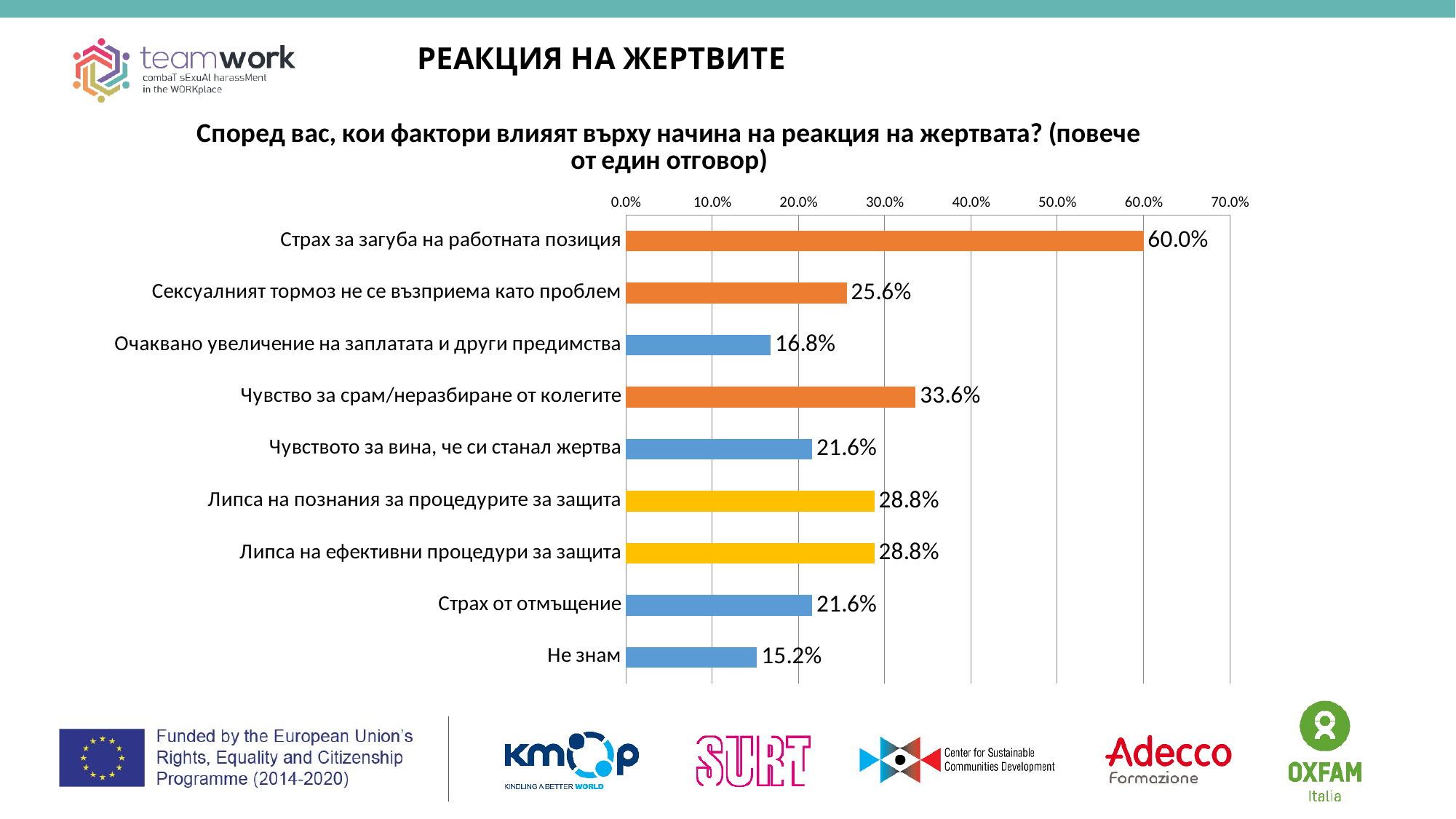
What is the difference between "Страх за загуба на работната позиция" and "Сексуалният тормоз не се възприема като проблем"? 34.4% What is the value for "Страх за загуба на работната позиция"? 60.0% What is the value for "Липса на ефективни процедури за защита"? 28.8% What kind of chart is shown on the slide? bar chart How many categories are shown in the chart? 9 Which is larger: "Очаквано увеличение на заплатата и други предимства" or "Чувството за вина, че си станал жертва"? Чувството за вина, че си станал жертва What is the maximum value shown on the horizontal axis? 70.0% Is the value for "Чувство за срам/неразбиране от колегите" greater or less than 30.0%? greater Which category has the lowest value? Не знам What is the value for "Чувство за срам/неразбиране от колегите"? 33.6% Which category has the highest value? Страх за загуба на работната позиция What is the value for "Не знам"? 15.2%